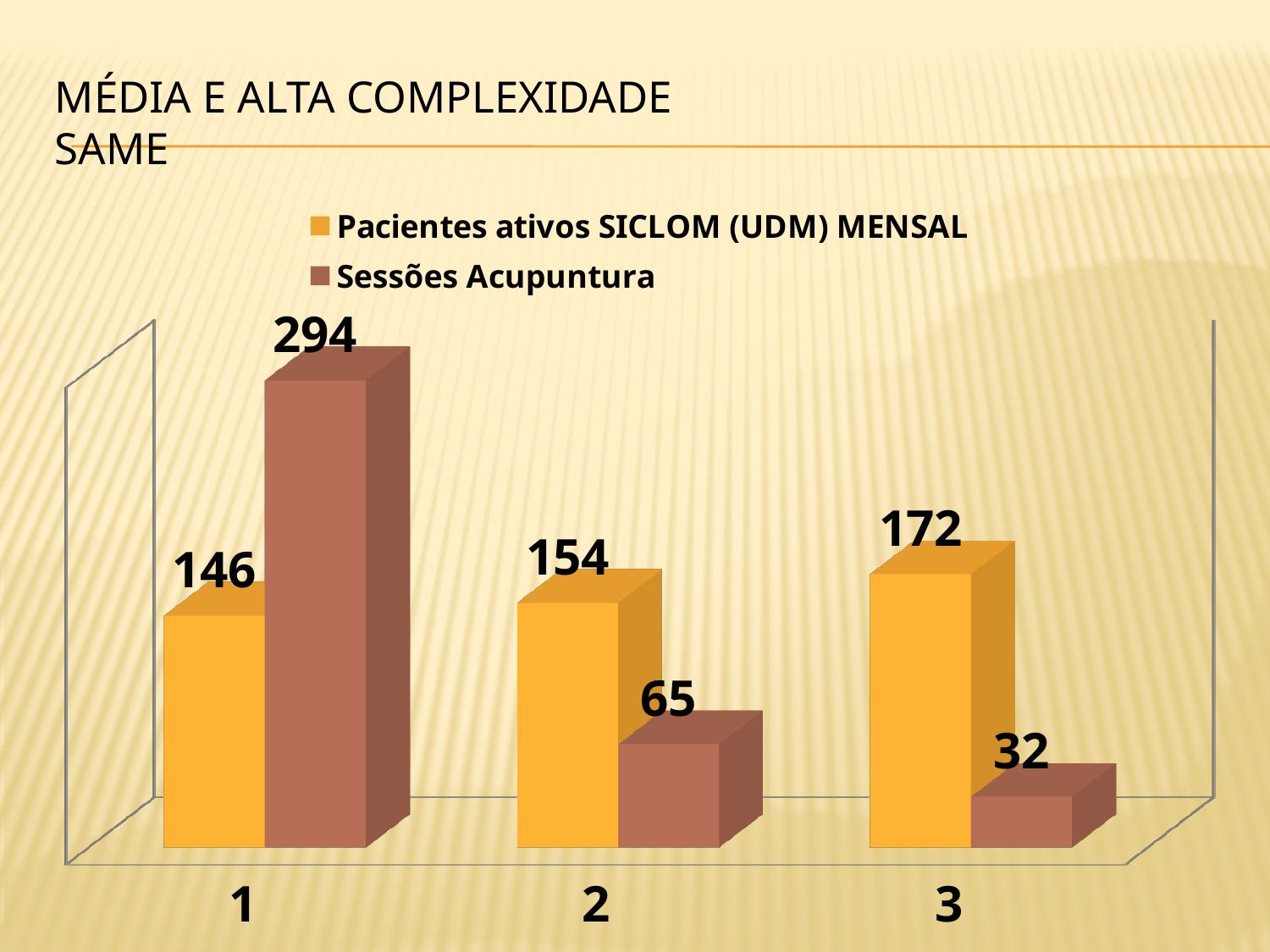
What is the value of Sessões Acupuntura for category 1? 294 How many series does the legend list? 2 Which category has the lowest value for Pacientes ativos SICLOM (UDM) MENSAL? 1 For category 3, which series has the larger value: Pacientes ativos SICLOM (UDM) MENSAL or Sessões Acupuntura? Pacientes ativos SICLOM (UDM) MENSAL What kind of chart is shown on the slide? Bar chart What is the value of Pacientes ativos SICLOM (UDM) MENSAL for category 3? 172 What is the value of Sessões Acupuntura for category 2? 65 What is the value of Pacientes ativos SICLOM (UDM) MENSAL for category 1? 146 What is the difference in Sessões Acupuntura between category 2 and category 3? 33 What is the difference between Sessões Acupuntura and Pacientes ativos SICLOM (UDM) MENSAL for category 1? 148 How many categories are shown on the x axis? 3 Which category has the highest value for Sessões Acupuntura? 1